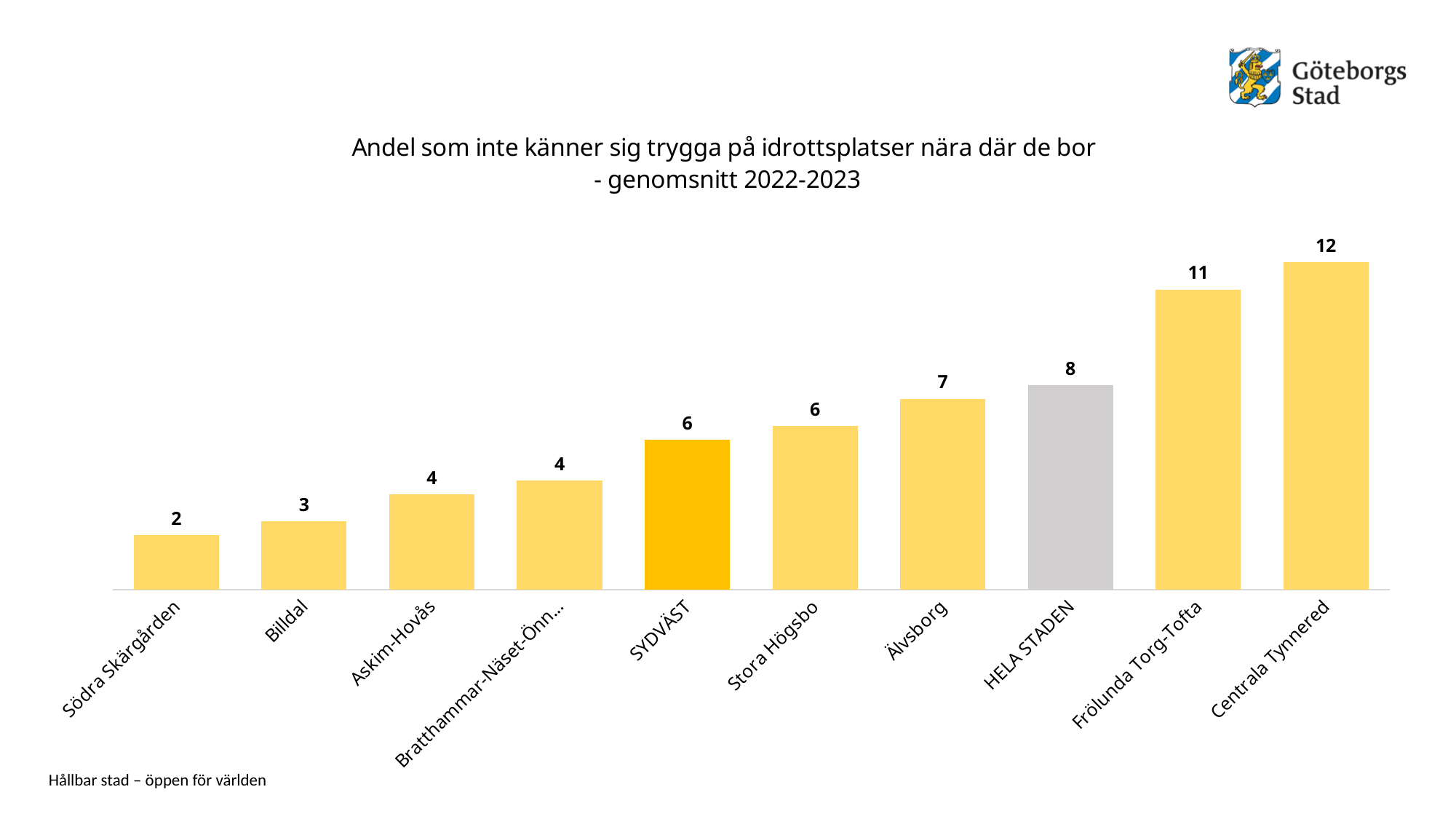
What is the value for Billdal? 3 Which category has the lowest value? Södra Skärgården How many categories are shown in the chart? 10 What kind of chart is shown on the slide? Bar chart Which category has the highest value? Centrala Tynnered What is the difference between the values for Centrala Tynnered and Frölunda Torg-Tofta? 1 Which is larger, the value for Älvsborg or the value for Askim-Hovås? Älvsborg What is the value for HELA STADEN? 8 What is the value for SYDVÄST? 6 What is the difference between the values for HELA STADEN and Södra Skärgården? 6 Do the values rise or fall from left to right along the x axis? Rise What is the value for Centrala Tynnered? 12